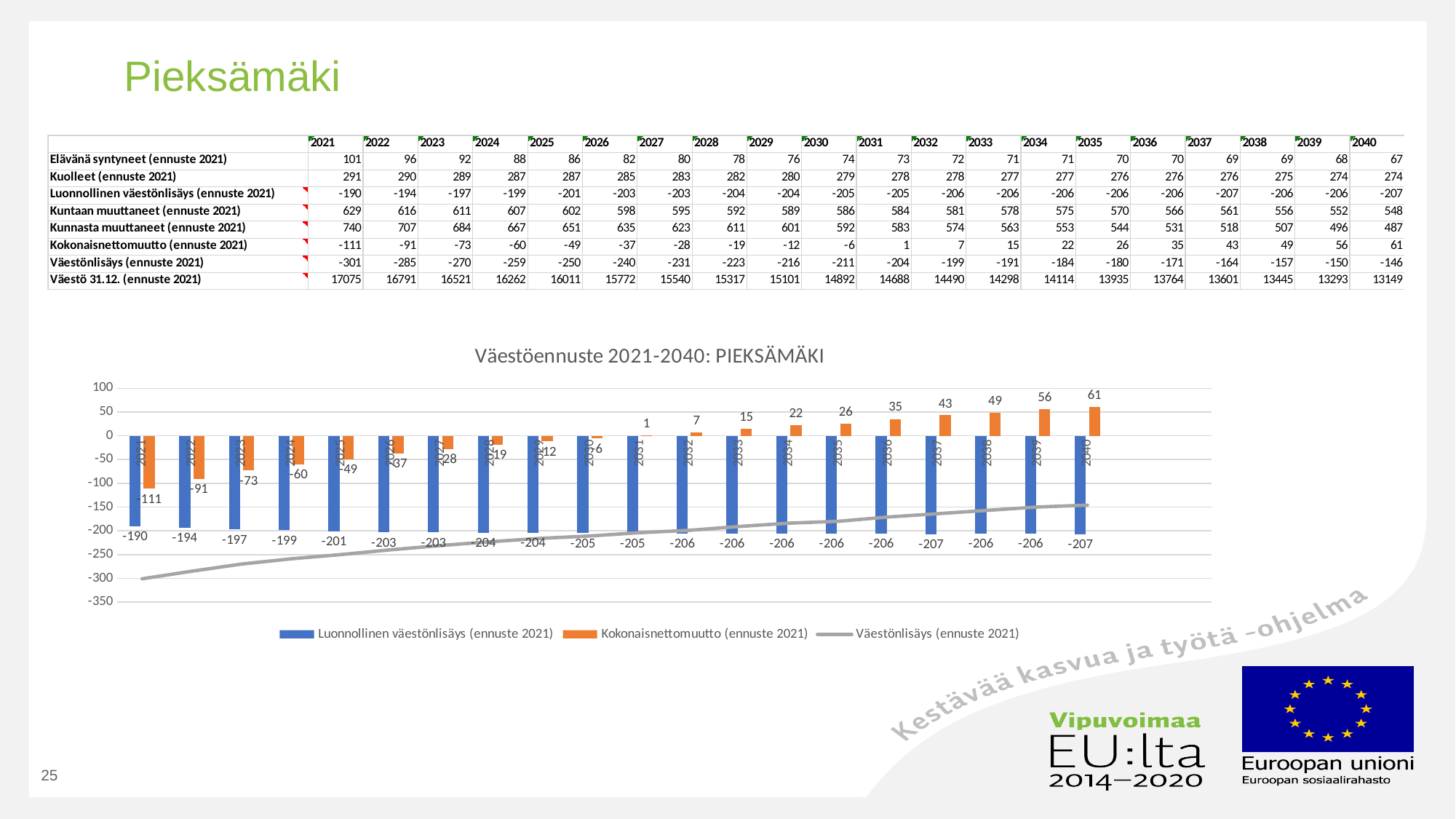
In the chart 'Väestöennuste 2021-2040: PIEKSÄMÄKI', what is the value of Luonnollinen väestönlisäys (ennuste 2021) for 2040? -207 How many series does the legend of the chart 'Väestöennuste 2021-2040: PIEKSÄMÄKI' list? 3 In the chart 'Väestöennuste 2021-2040: PIEKSÄMÄKI', is the Kokonaisnettomuutto (ennuste 2021) value larger in 2030 or in 2031? 2031 In the chart 'Väestöennuste 2021-2040: PIEKSÄMÄKI', is the value of the Väestönlisäys (ennuste 2021) line for 2021 greater or less than -250? less In the chart 'Väestöennuste 2021-2040: PIEKSÄMÄKI', what is the difference between the Kokonaisnettomuutto (ennuste 2021) values for 2040 and 2021? 172 In the chart 'Väestöennuste 2021-2040: PIEKSÄMÄKI', what is the value of Kokonaisnettomuutto (ennuste 2021) for 2021? -111 In the chart 'Väestöennuste 2021-2040: PIEKSÄMÄKI', which year has the lowest value for Kokonaisnettomuutto (ennuste 2021)? 2021 In the chart 'Väestöennuste 2021-2040: PIEKSÄMÄKI', which year has the highest value for Kokonaisnettomuutto (ennuste 2021)? 2040 In the chart 'Väestöennuste 2021-2040: PIEKSÄMÄKI', do the Kokonaisnettomuutto (ennuste 2021) values rise or fall from 2021 to 2040? rise In the chart 'Väestöennuste 2021-2040: PIEKSÄMÄKI', what is the value of Kokonaisnettomuutto (ennuste 2021) for 2035? 26 What kind of chart is 'Väestöennuste 2021-2040: PIEKSÄMÄKI'? Bar chart with a line How many years are shown on the x axis of the chart 'Väestöennuste 2021-2040: PIEKSÄMÄKI'? 20